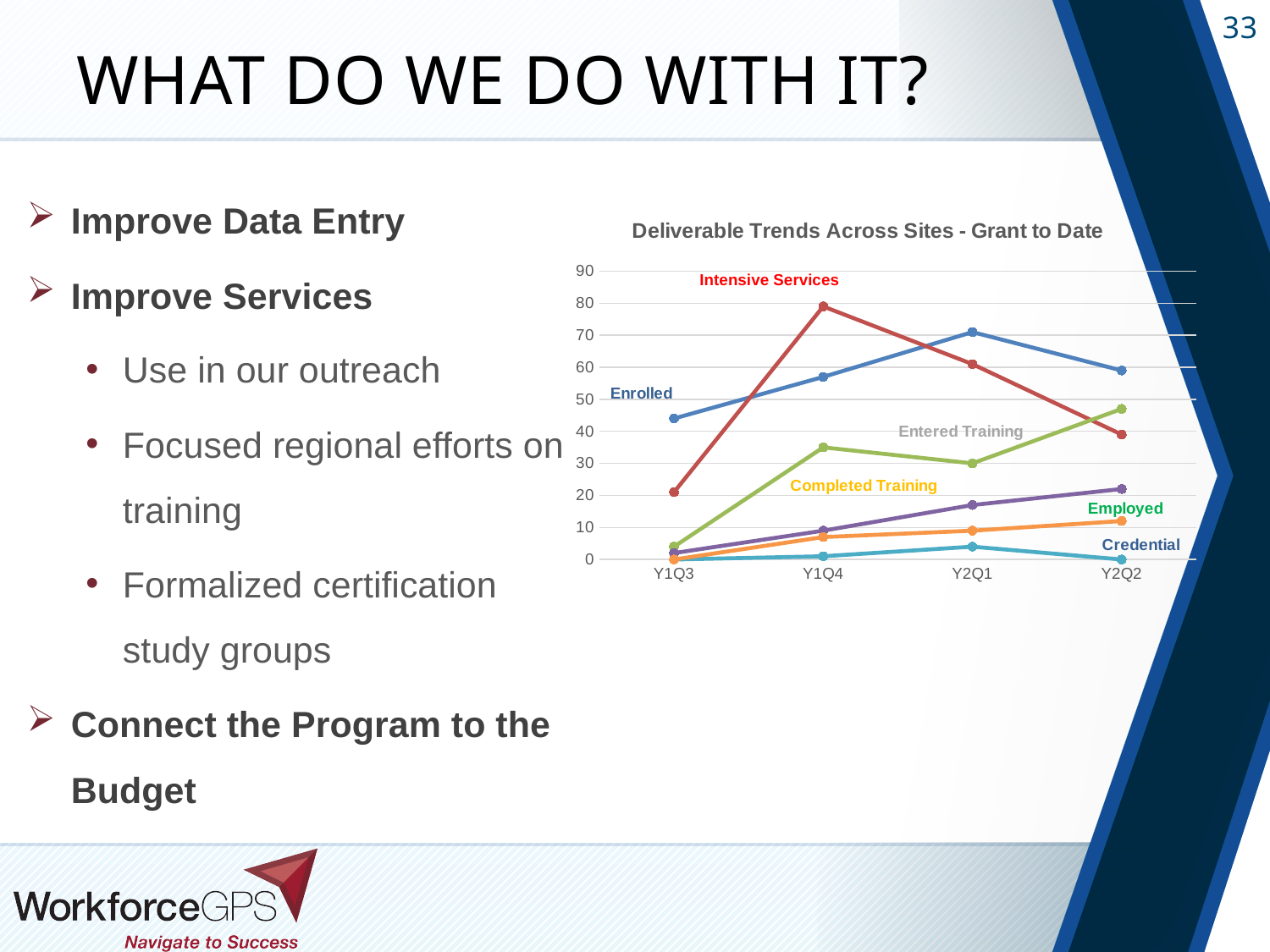
Which series has the highest value at Y1Q4? Intensive Services What is the title of the chart? Deliverable Trends Across Sites - Grant to Date Is the value for Enrolled at Y1Q3 greater or less than 50? less Which series has the highest value at Y2Q1? Enrolled Is the value for Entered Training at Y2Q2 greater or less than 40? greater How many data series are plotted in the chart? 6 How many time periods are shown on the x axis of the chart? 4 Is the value for Intensive Services at Y1Q4 greater or less than 70? greater What kind of chart is shown on the slide? line chart Which series has the lowest value at Y2Q2? Credential Does the Employed series rise or fall from Y1Q3 to Y2Q2? rise At Y2Q2, which is larger: Entered Training or Intensive Services? Entered Training